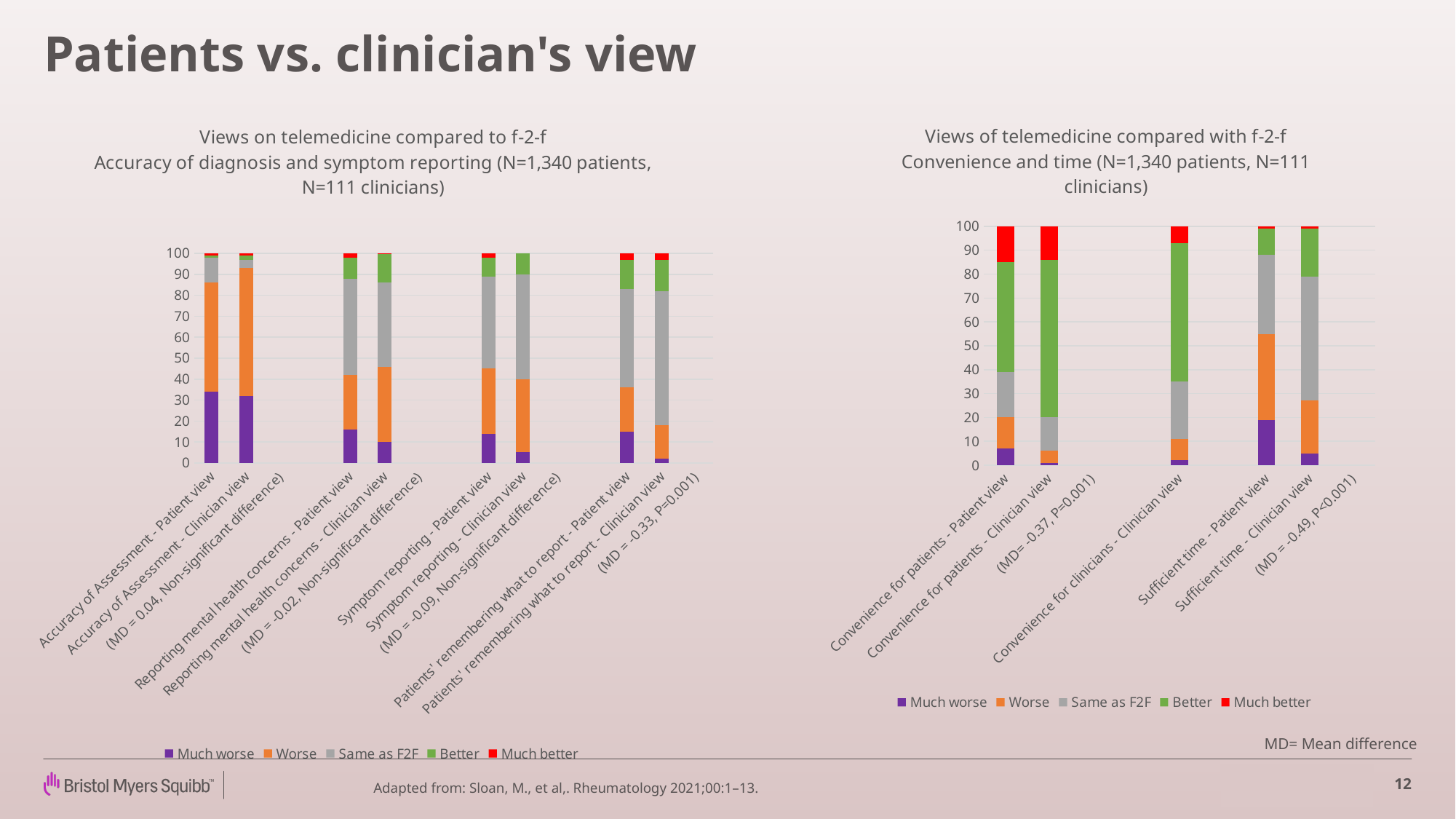
In the right chart, which has the larger 'Much better' segment: 'Convenience for patients - Patient view' or 'Sufficient time - Patient view'? Convenience for patients - Patient view What colour represents 'Same as F2F' in the legends of both charts? Grey In the right chart, 'Views of telemedicine compared with f-2-f Convenience and time', how many stacked bars are plotted? 5 What kind of chart is the left chart, 'Views on telemedicine compared to f-2-f Accuracy of diagnosis and symptom reporting'? Stacked bar chart In the left chart, is the 'Much worse' value for 'Accuracy of Assessment - Patient view' greater or less than 20? greater In the right chart, which bar has the largest 'Same as F2F' segment? Sufficient time - Clinician view In the left chart, is the 'Worse' segment for 'Accuracy of Assessment - Clinician view' greater or less than 50? greater In the right chart, is the 'Much worse' value for 'Convenience for clinicians - Clinician view' greater or less than 10? less In the left chart, which bar has the largest 'Worse' segment? Accuracy of Assessment - Clinician view In the left chart, 'Views on telemedicine compared to f-2-f Accuracy of diagnosis and symptom reporting', how many stacked bars are plotted? 8 How many series does the legend of the right chart, 'Views of telemedicine compared with f-2-f Convenience and time', list? 5